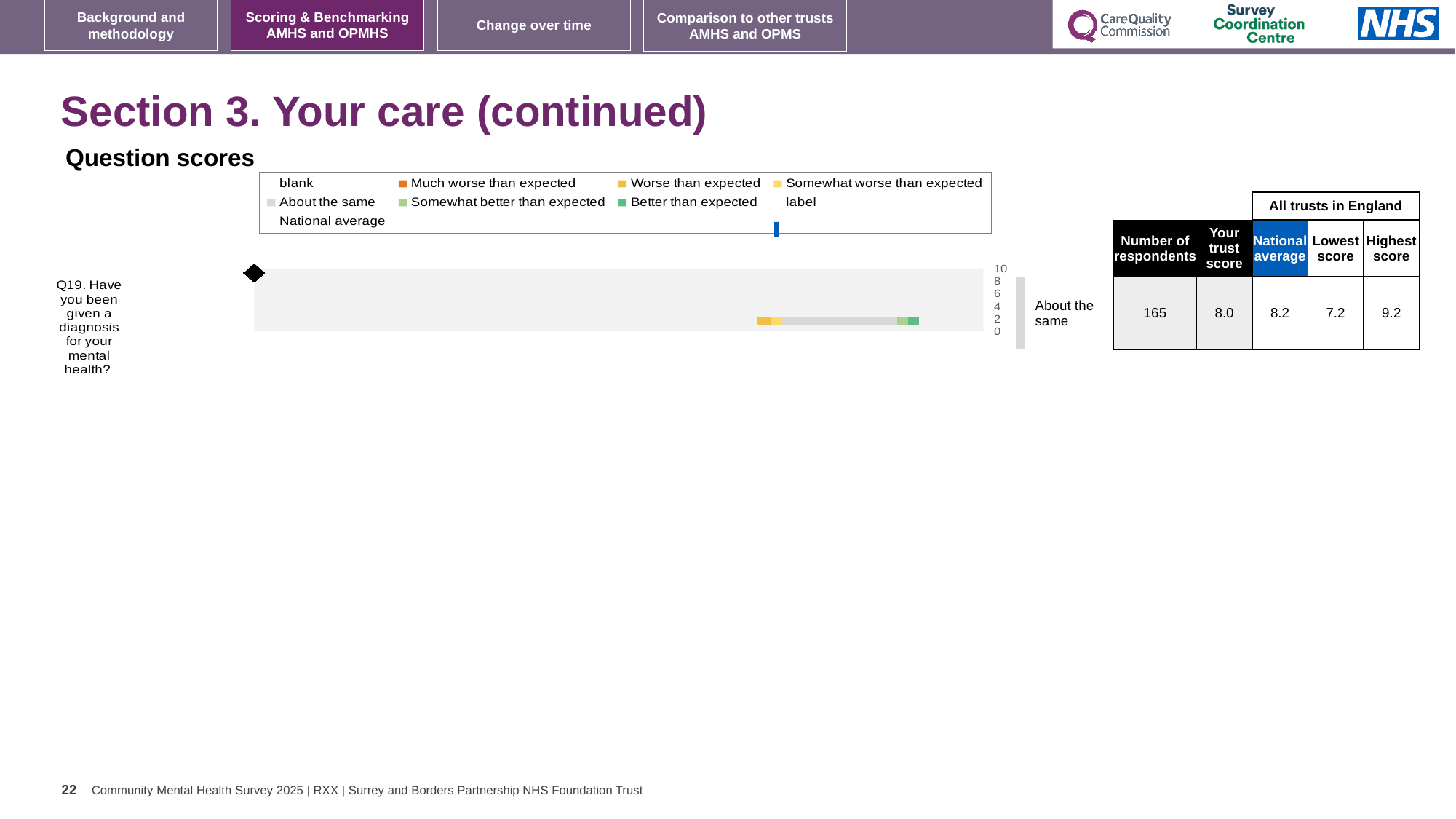
For Q19, what is the difference between the highest score and the lowest score among all trusts in England? 2.0 In the table beside the chart, what is the 'Your trust score' for Q19? 8.0 In the table beside the chart, what is the lowest score among all trusts in England for Q19? 7.2 In the table beside the chart, what is the national average for Q19? 8.2 Which survey question is plotted in the chart? Q19. Have you been given a diagnosis for your mental health? For Q19, which is larger: the trust score or the national average? National average How many survey questions are plotted in the chart? 1 In the table beside the chart, what is the number of respondents for Q19? 165 What benchmark category label is shown to the right of the Q19 bar? About the same What kind of chart is shown under 'Question scores'? bar chart In the table beside the chart, what is the highest score among all trusts in England for Q19? 9.2